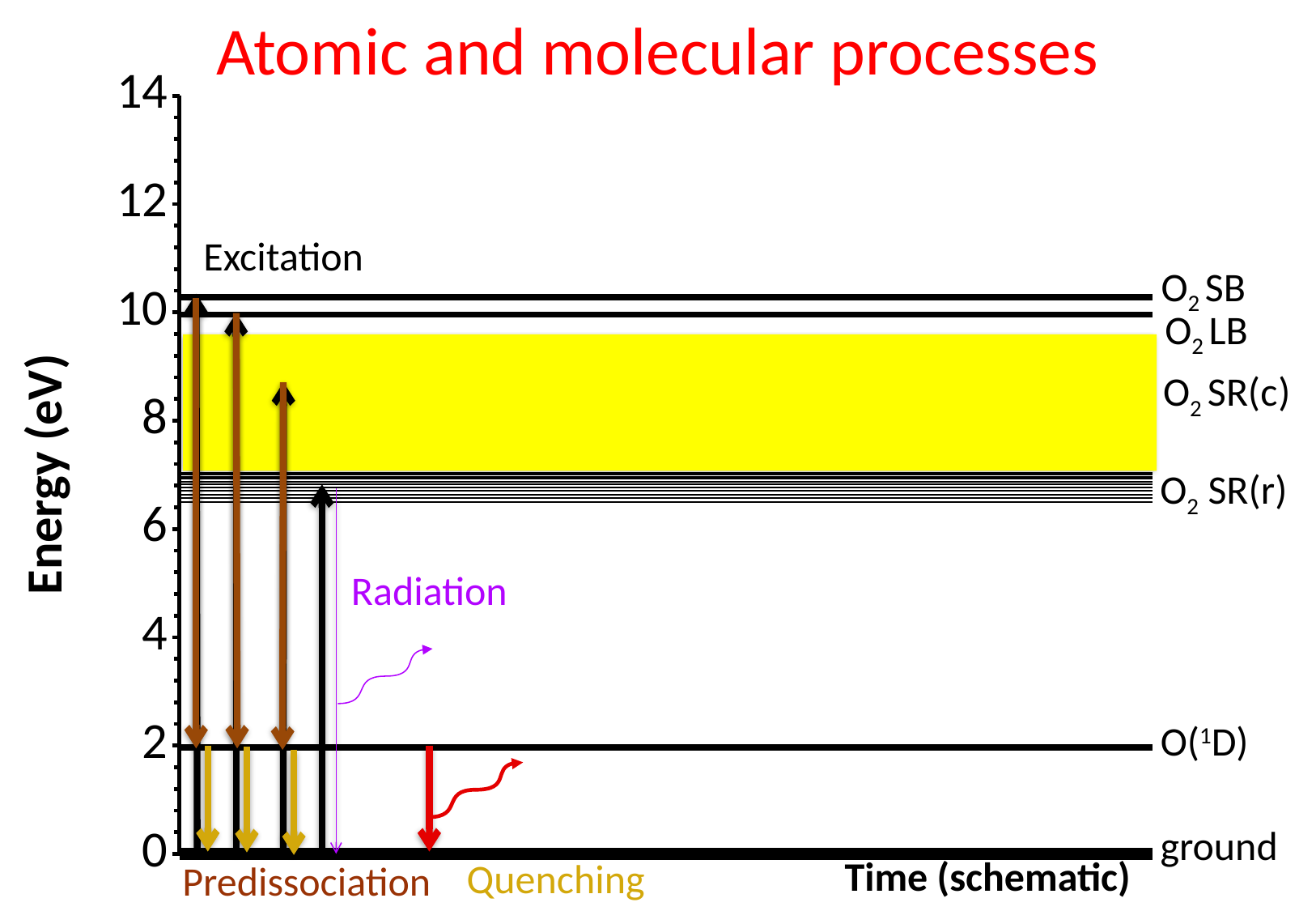
Which labeled energy level is the highest? O2 SB Is the energy of the O2 SB level greater or less than 8 eV? greater What is the title of the chart? Atomic and molecular processes Which level has the higher energy, O2 LB or O(1D)? O2 LB Is the energy of the O(1D) level greater or less than 4 eV? less Which labeled energy level is the lowest? ground What is the label of the vertical axis? Energy (eV) What is the energy of the ground level in eV? 0 What is the highest tick value shown on the energy axis? 14 How many labeled energy levels are shown on the right side of the chart? 6 What kind of chart is shown on the slide? Energy level diagram Is the energy of the O2 SR(r) level greater or less than 6 eV? greater